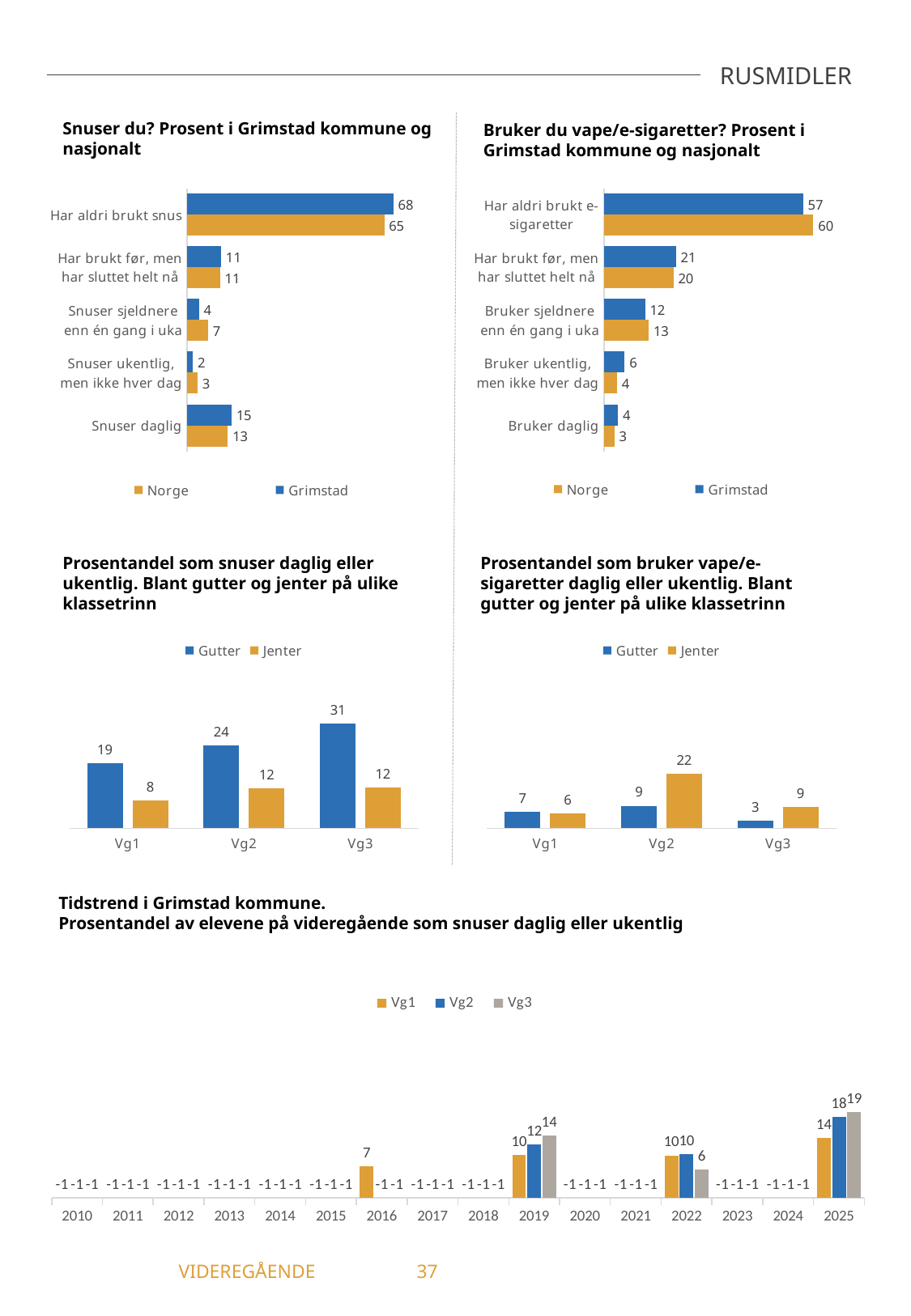
In the chart 'Prosentandel som bruker vape/e-sigaretter daglig eller ukentlig. Blant gutter og jenter på ulike klassetrinn', which class level has the highest Jenter value? Vg2 In the chart 'Bruker du vape/e-sigaretter? Prosent i Grimstad kommune og nasjonalt', which is larger for 'Bruker ukentlig, men ikke hver dag': Grimstad or Norge? Grimstad In the chart 'Tidstrend i Grimstad kommune', what is the value for Vg3 in 2025? 19 In the chart 'Prosentandel som snuser daglig eller ukentlig. Blant gutter og jenter på ulike klassetrinn', what is the value for Gutter at Vg3? 31 In the chart 'Bruker du vape/e-sigaretter? Prosent i Grimstad kommune og nasjonalt', what is the Norge value for 'Har aldri brukt e-sigaretter'? 60 In the chart 'Prosentandel som snuser daglig eller ukentlig. Blant gutter og jenter på ulike klassetrinn', do the Gutter values rise or fall from Vg1 to Vg3? rise In the chart 'Snuser du? Prosent i Grimstad kommune og nasjonalt', how many categories are shown on the vertical axis? 5 In the chart 'Snuser du? Prosent i Grimstad kommune og nasjonalt', what is the value for Grimstad for 'Har aldri brukt snus'? 68 In the chart 'Prosentandel som bruker vape/e-sigaretter daglig eller ukentlig. Blant gutter og jenter på ulike klassetrinn', what is the difference between Jenter and Gutter at Vg2? 13 In the chart 'Snuser du? Prosent i Grimstad kommune og nasjonalt', what is the difference between the Grimstad and Norge values for 'Snuser daglig'? 2 In the chart 'Tidstrend i Grimstad kommune', how many series does the legend list? 3 In the chart 'Bruker du vape/e-sigaretter? Prosent i Grimstad kommune og nasjonalt', which category has the lowest Norge value? Bruker daglig